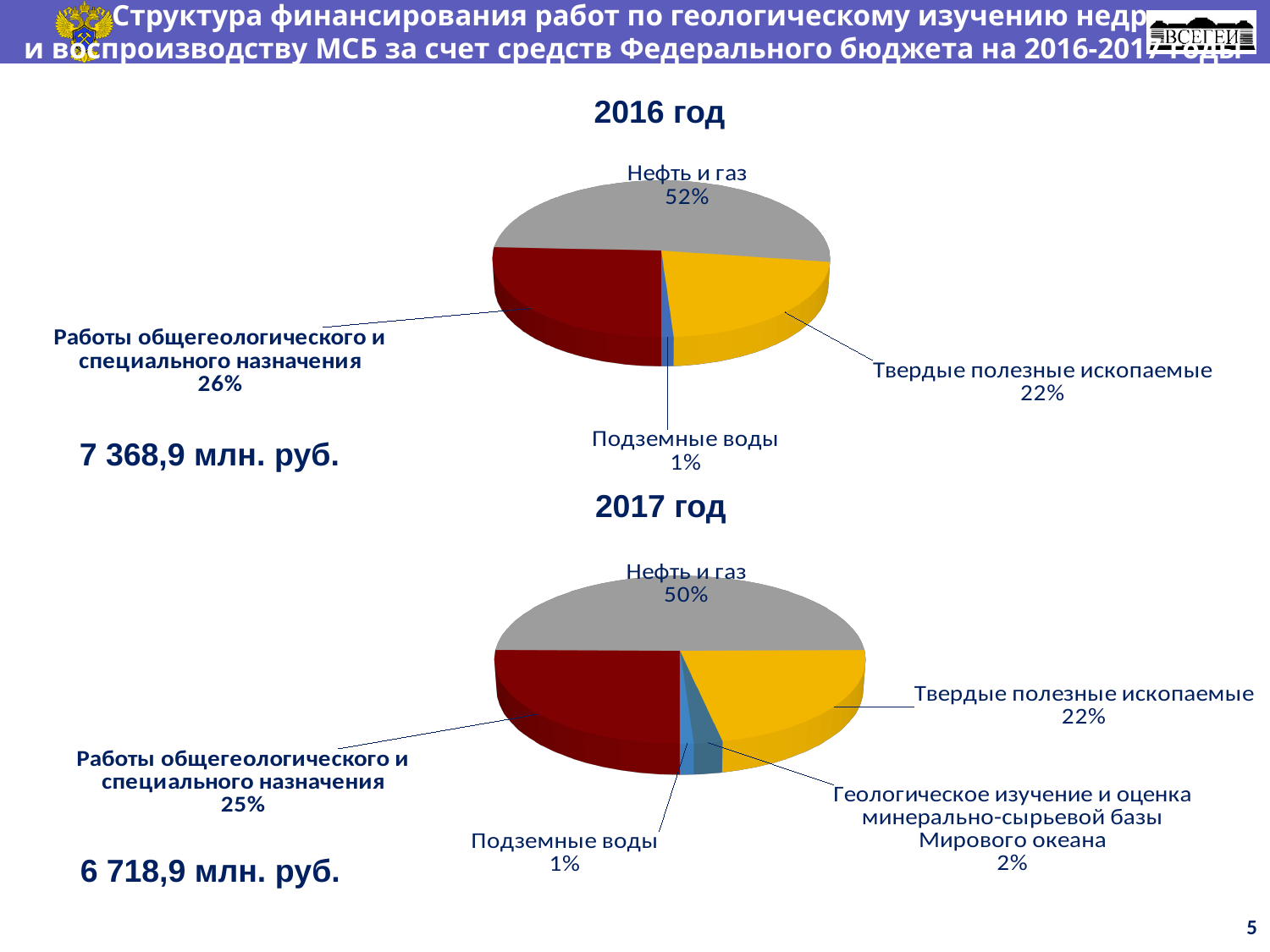
How many categories are shown in the "2017 год" chart? 5 What total amount in млн. руб. is shown next to the "2017 год" chart? 6 718,9 млн. руб. In the "2017 год" chart, which is larger: "Твердые полезные ископаемые" or "Работы общегеологического и специального назначения"? Работы общегеологического и специального назначения In the "2016 год" chart, what share does "Нефть и газ" have? 52% In the "2016 год" chart, which category has the largest share? Нефть и газ What type of chart is the "2016 год" chart? Pie chart In the "2017 год" chart, which category has the smallest share? Подземные воды In the "2017 год" chart, what share does "Нефть и газ" have? 50% How many categories are shown in the "2016 год" chart? 4 In the "2016 год" chart, what is the difference in percentage points between "Нефть и газ" and "Твердые полезные ископаемые"? 30 In the "2017 год" chart, what is the share for "Геологическое изучение и оценка минерально-сырьевой базы Мирового океана"? 2% In the "2016 год" chart, what is the share for "Работы общегеологического и специального назначения"? 26%